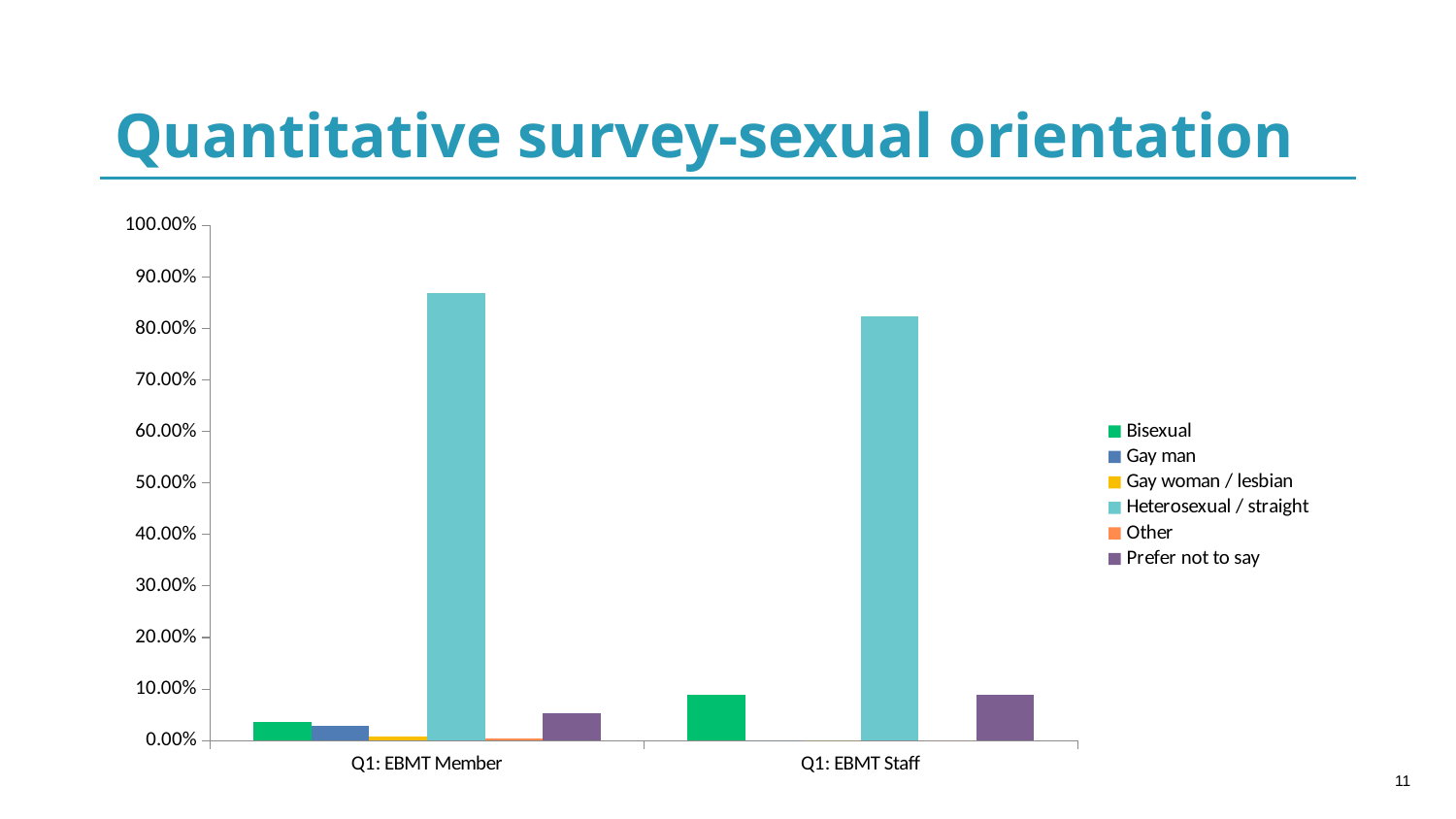
Is the Heterosexual / straight value for Q1: EBMT Staff greater or less than 90.00%? less Which series has the highest value for Q1: EBMT Staff? Heterosexual / straight Which legend entry is shown in yellow? Gay woman / lesbian How many series does the legend list? 6 How many categories are shown on the x axis? 2 Which is larger: the Bisexual value for Q1: EBMT Member or for Q1: EBMT Staff? Q1: EBMT Staff What kind of chart is shown on the slide? Bar chart Which series has the highest value for Q1: EBMT Member? Heterosexual / straight Is the Heterosexual / straight value for Q1: EBMT Member greater or less than 80.00%? greater What is the title of the slide? Quantitative survey-sexual orientation Is the Bisexual value for Q1: EBMT Staff greater or less than 10.00%? less Which is larger: the Heterosexual / straight value for Q1: EBMT Member or for Q1: EBMT Staff? Q1: EBMT Member